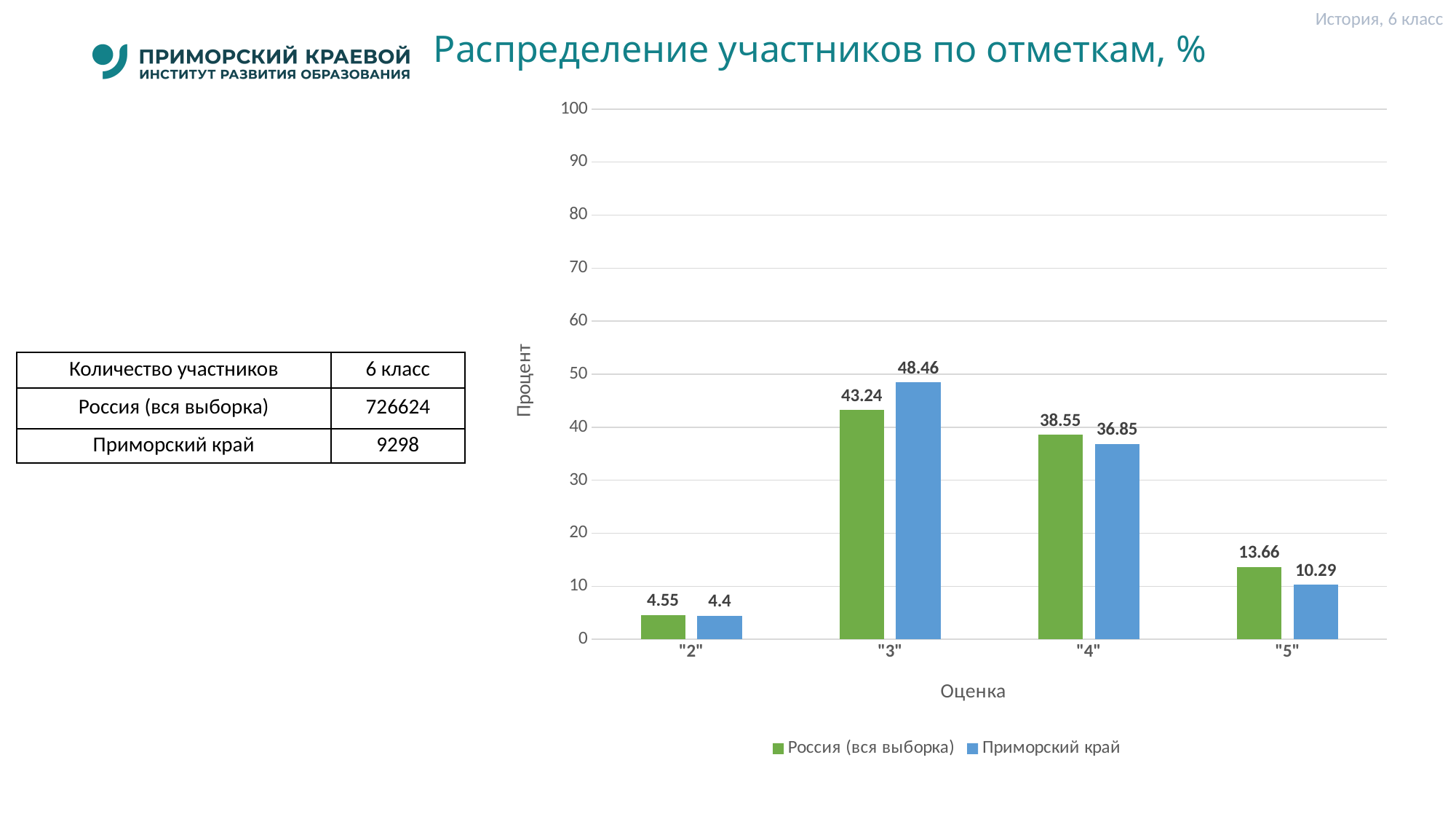
Is the value for Приморский край at grade "3" greater or less than 40? greater What is the value for Приморский край at grade "5"? 10.29 What is the value for Россия (вся выборка) at grade "4"? 38.55 Which grade has the highest value for Россия (вся выборка)? "3" What is the title of the chart? Распределение участников по отметкам, % What kind of chart is shown on the slide? bar chart What is the difference between Россия (вся выборка) and Приморский край at grade "4"? 1.7 Which grade has the lowest value for Приморский край? "2" Which is larger at grade "5": Россия (вся выборка) or Приморский край? Россия (вся выборка) How many series does the legend list? 2 How many grade categories are shown on the x axis? 4 What is the value for Приморский край at grade "3"? 48.46